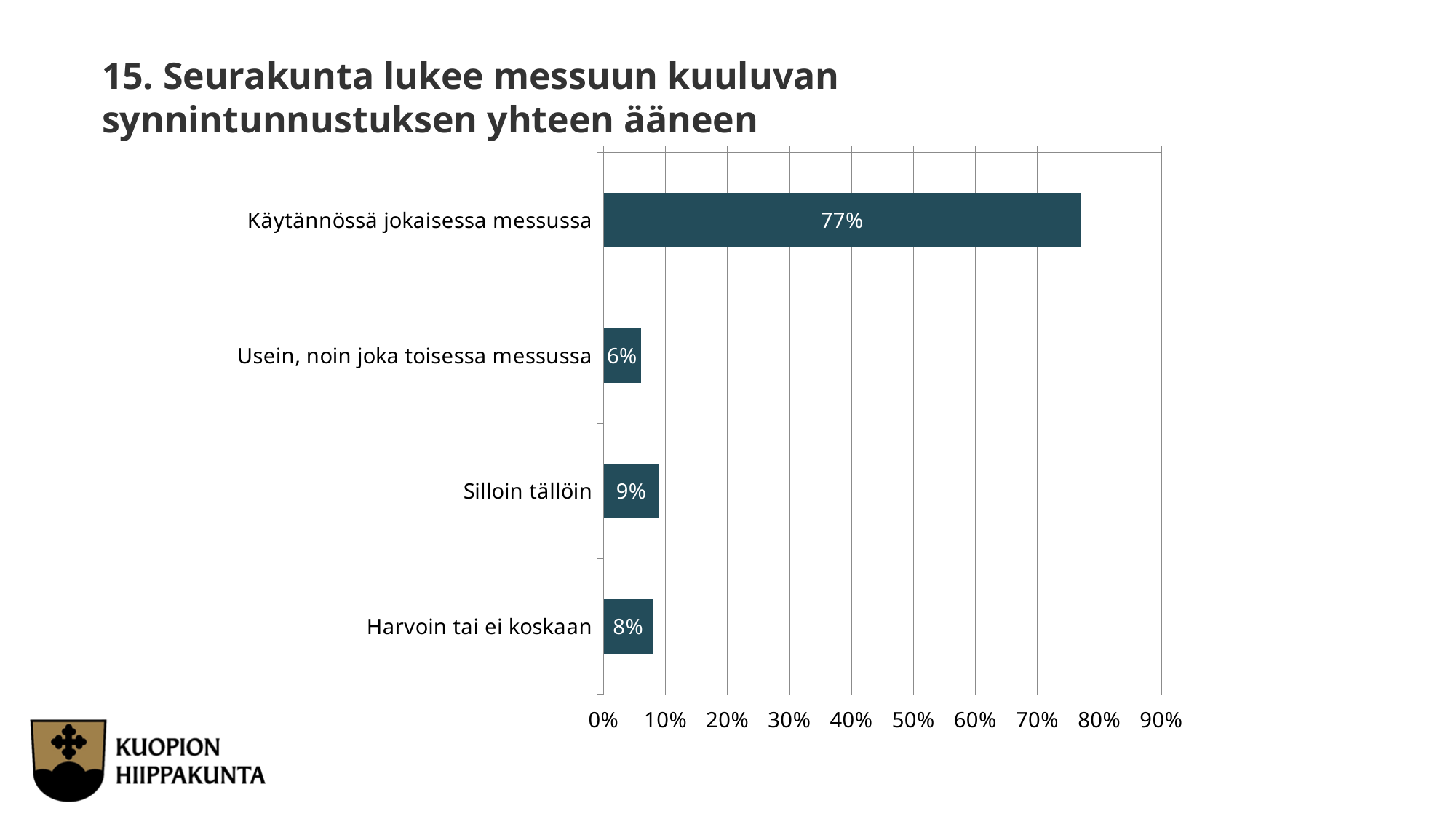
What is the difference between the values for "Käytännössä jokaisessa messussa" and "Silloin tällöin"? 68% What kind of chart is shown on the slide? Bar chart What is the value for "Usein, noin joka toisessa messussa"? 6% What is the value for "Käytännössä jokaisessa messussa"? 77% What is the difference between the values for "Silloin tällöin" and "Usein, noin joka toisessa messussa"? 3% Which category has the lowest value? Usein, noin joka toisessa messussa Which category has the highest value? Käytännössä jokaisessa messussa How many categories are shown in the chart? 4 Which is larger, the value for "Silloin tällöin" or the value for "Harvoin tai ei koskaan"? Silloin tällöin What is the value for "Silloin tällöin"? 9% What is the value for "Harvoin tai ei koskaan"? 8% Is the value for "Käytännössä jokaisessa messussa" greater or less than 70%? greater